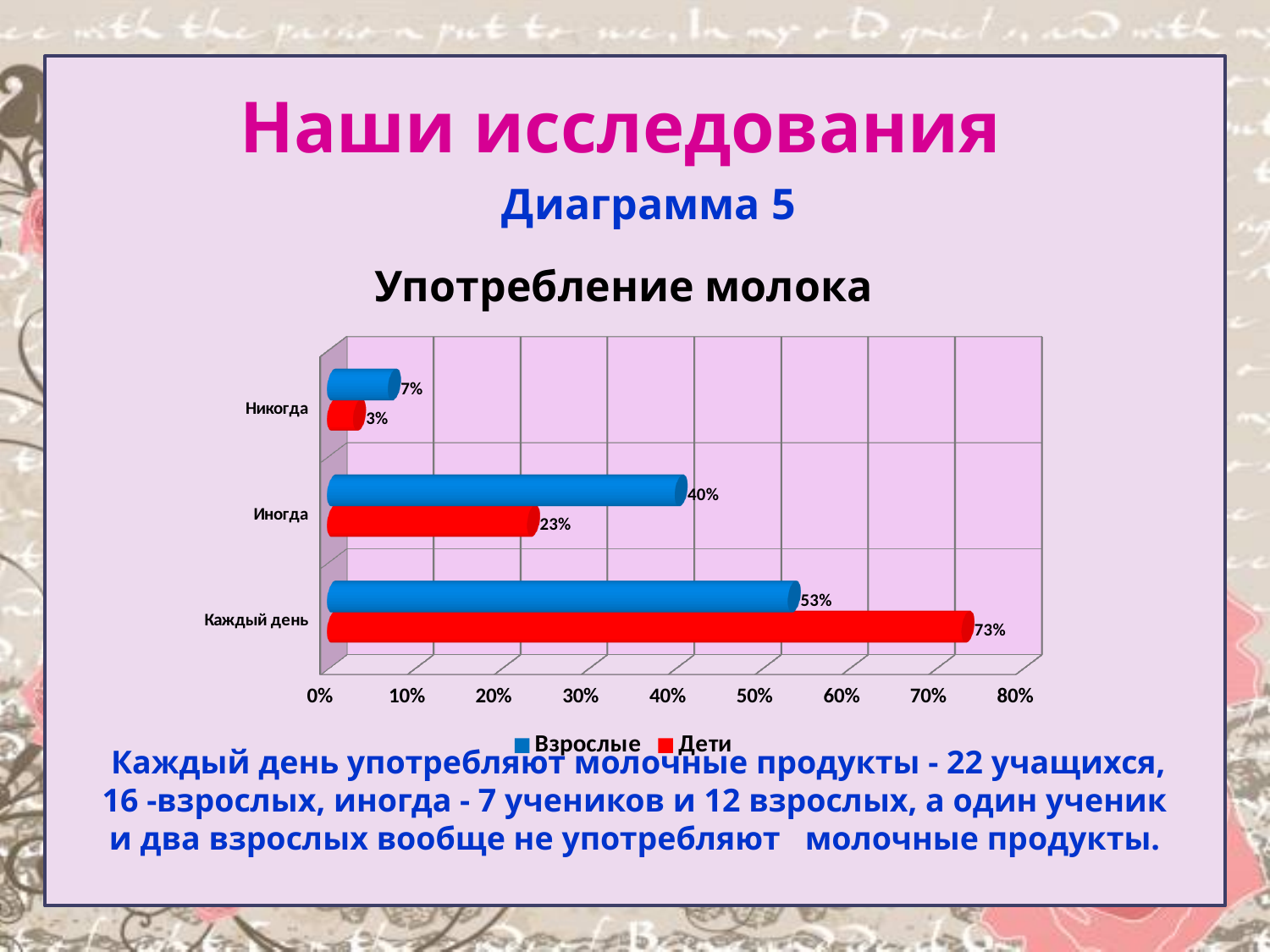
What is the value for Взрослые in the Иногда category? 40% What is the value for Взрослые in the Никогда category? 7% What kind of chart is shown on the slide? Bar chart Which is larger in the Иногда category, Взрослые or Дети? Взрослые What is the difference between Дети and Взрослые in the Каждый день category? 20% What is the title of the chart? Употребление молока What is the value for Дети in the Иногда category? 23% What is the value for Дети in the Каждый день category? 73% Which category has the lowest value for Взрослые? Никогда Which category has the highest value for Дети? Каждый день How many series does the legend list? 2 How many categories are shown on the chart? 3